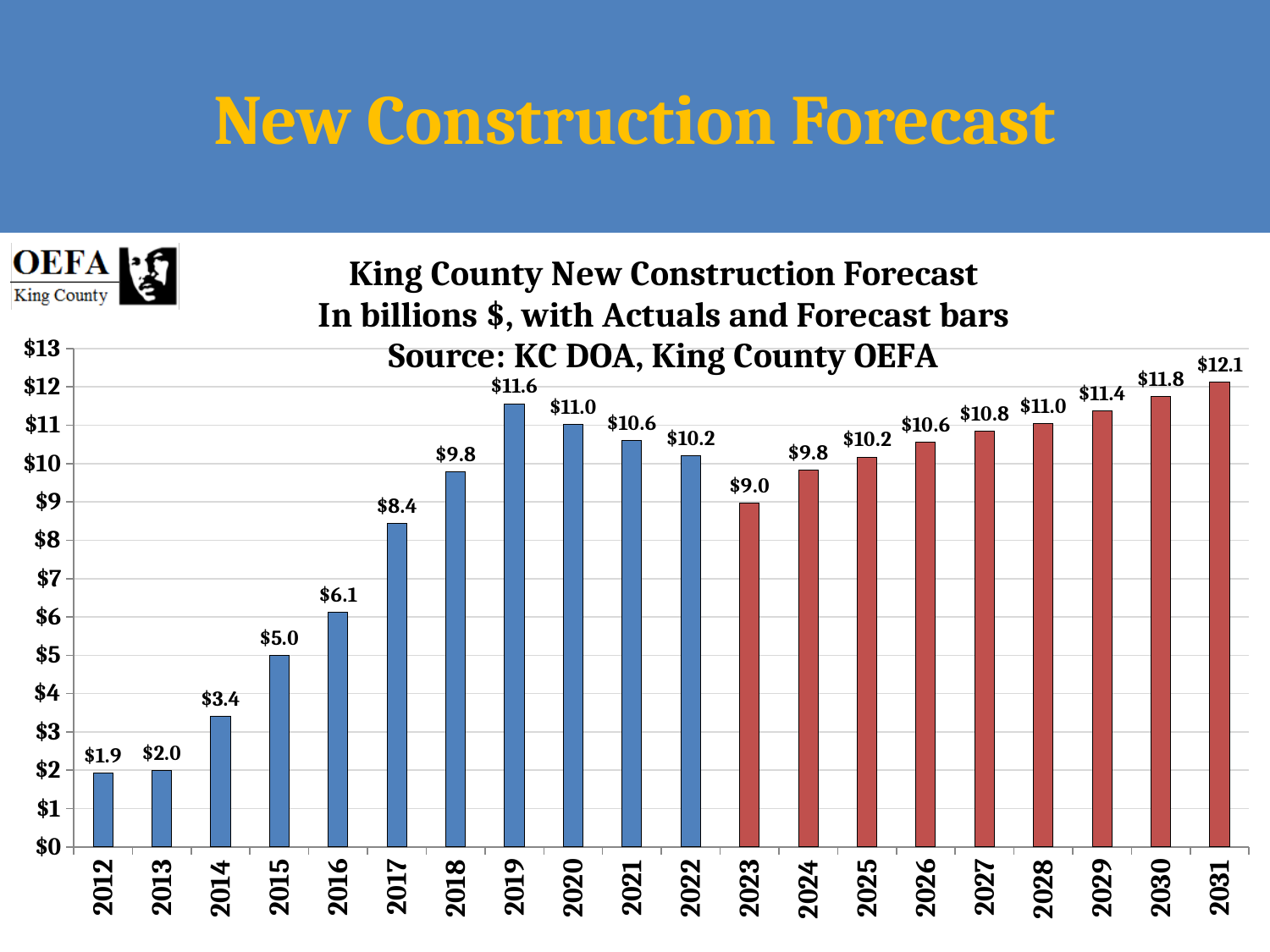
What is the value for 2031? $12.1 What is the value for 2023? $9.0 Do the values rise or fall from 2012 to 2019? Rise Which year has the highest value? 2031 What is the value for 2019? $11.6 How many years are shown on the x axis? 20 Which is larger, the value for 2018 or the value for 2024? They are equal ($9.8) Which is larger, the value for 2016 or the value for 2017? 2017 What kind of chart is this? Bar chart Is the value for 2022 greater or less than $10? greater What is the difference between the values for 2019 and 2023? $2.6 Which year has the lowest value? 2012